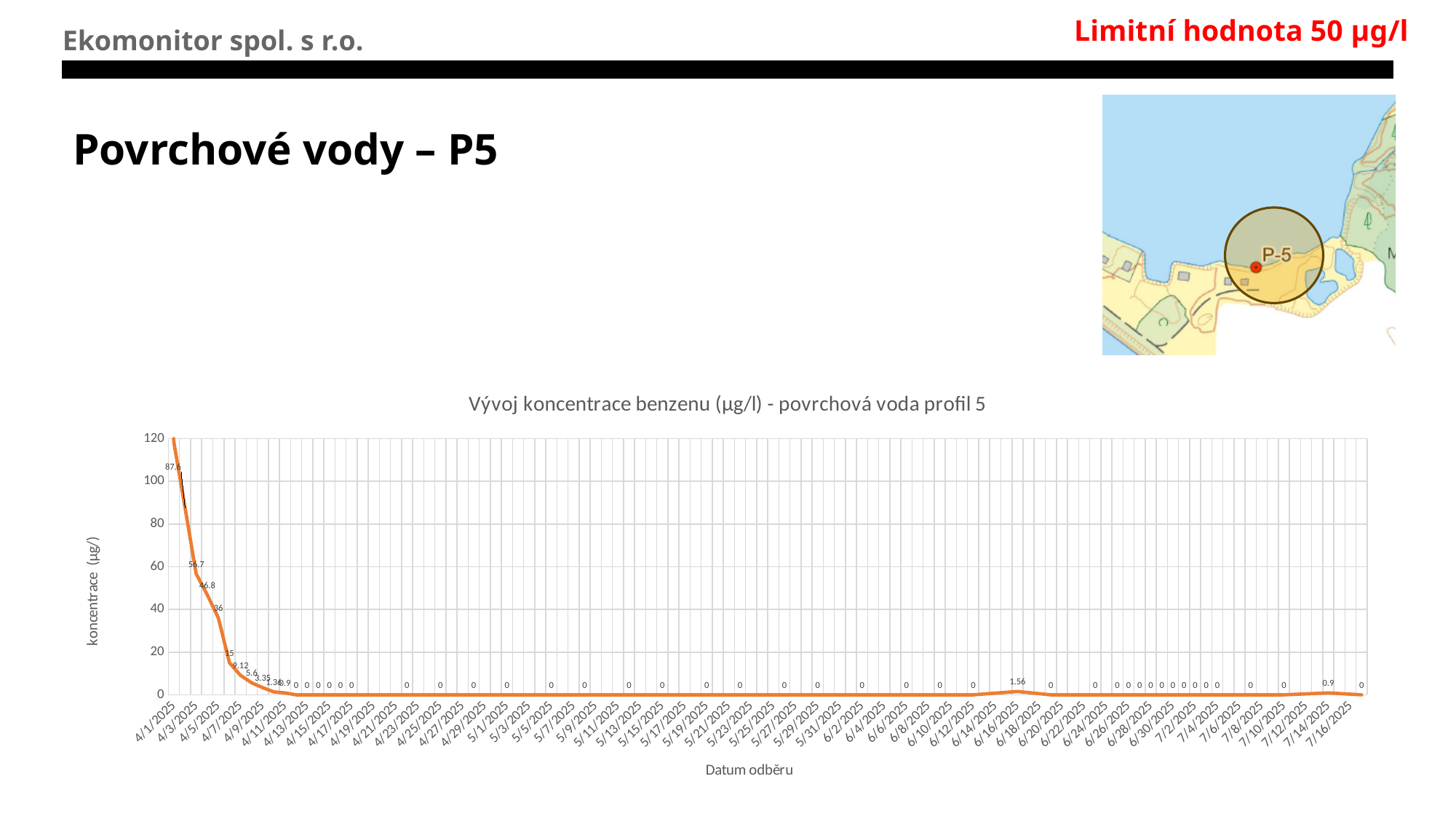
What kind of chart is shown on the slide? line chart What is the title of the chart? Vývoj koncentrace benzenu (µg/l) - povrchová voda profil 5 What value is labelled at 6/16/2025 in the chart? 1.56 What value is labelled at 7/14/2025 in the chart? 0.9 What is the label of the vertical axis of the chart? koncentrace (µg/l) Which date has the highest concentration in the chart? 4/1/2025 Is the value for 4/1/2025 greater or less than 100? greater Do the values in the chart generally rise or fall along the x axis from 4/1/2025 to 7/16/2025? fall Is the value for 4/5/2025 greater or less than 20? greater Is the value for 5/1/2025 greater or less than 20? less Which is larger, the value for 4/1/2025 or the value for 7/16/2025? 4/1/2025